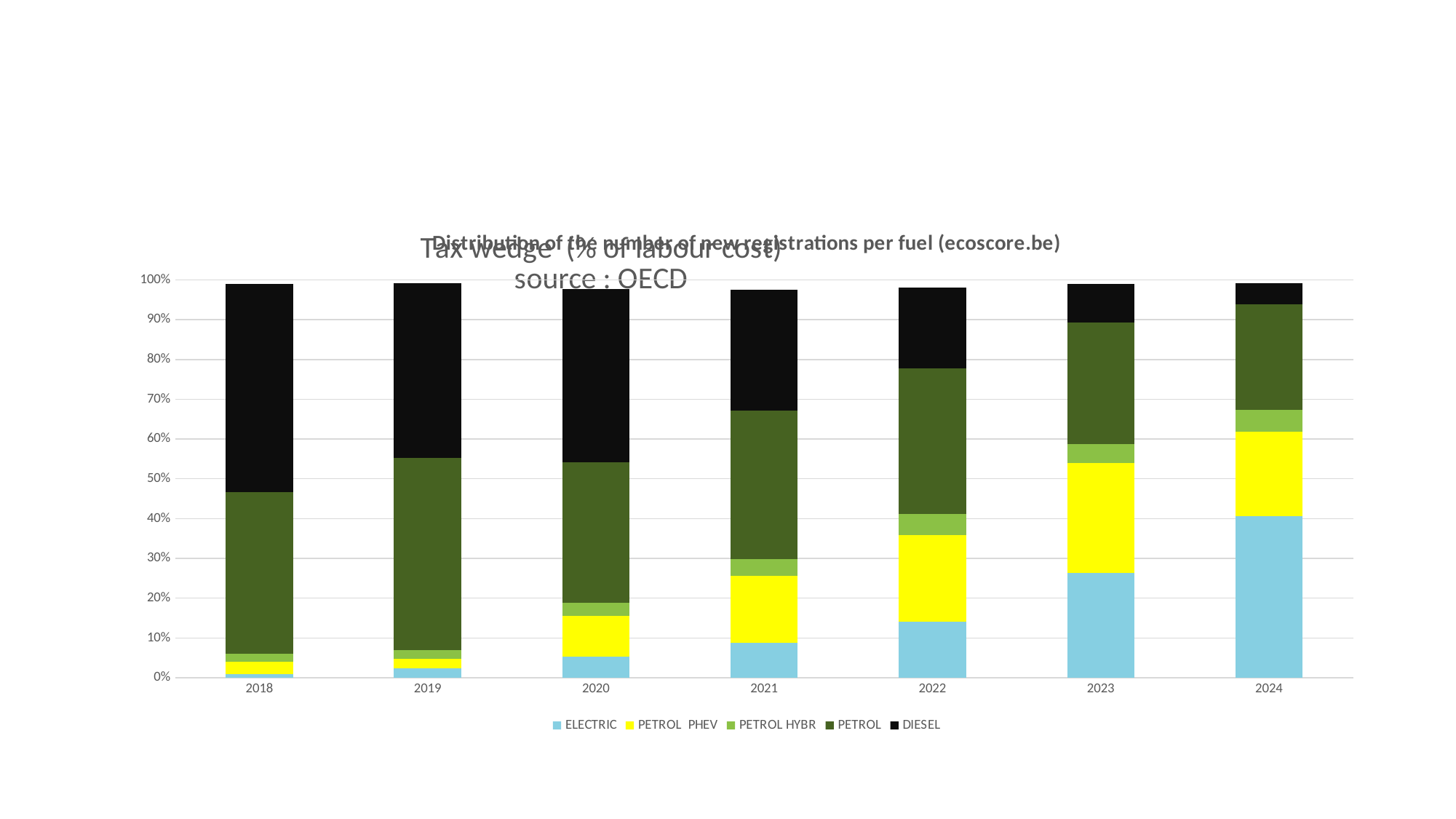
Which series is shown in black in the chart? DIESEL Which series is shown in light blue in the chart? ELECTRIC In which year is the DIESEL share the highest? 2018 Is the ELECTRIC share in 2024 greater or less than 30%? greater In which year is the ELECTRIC share the lowest? 2018 Does the DIESEL share rise or fall from 2018 to 2024? fall In which year is the ELECTRIC share the highest? 2024 Is the ELECTRIC share in 2021 greater or less than 10%? less What kind of chart is shown on the slide? stacked bar chart How many years are shown on the x axis of the chart? 7 Does the ELECTRIC share rise or fall from 2018 to 2024? rise How many series does the chart legend list? 5